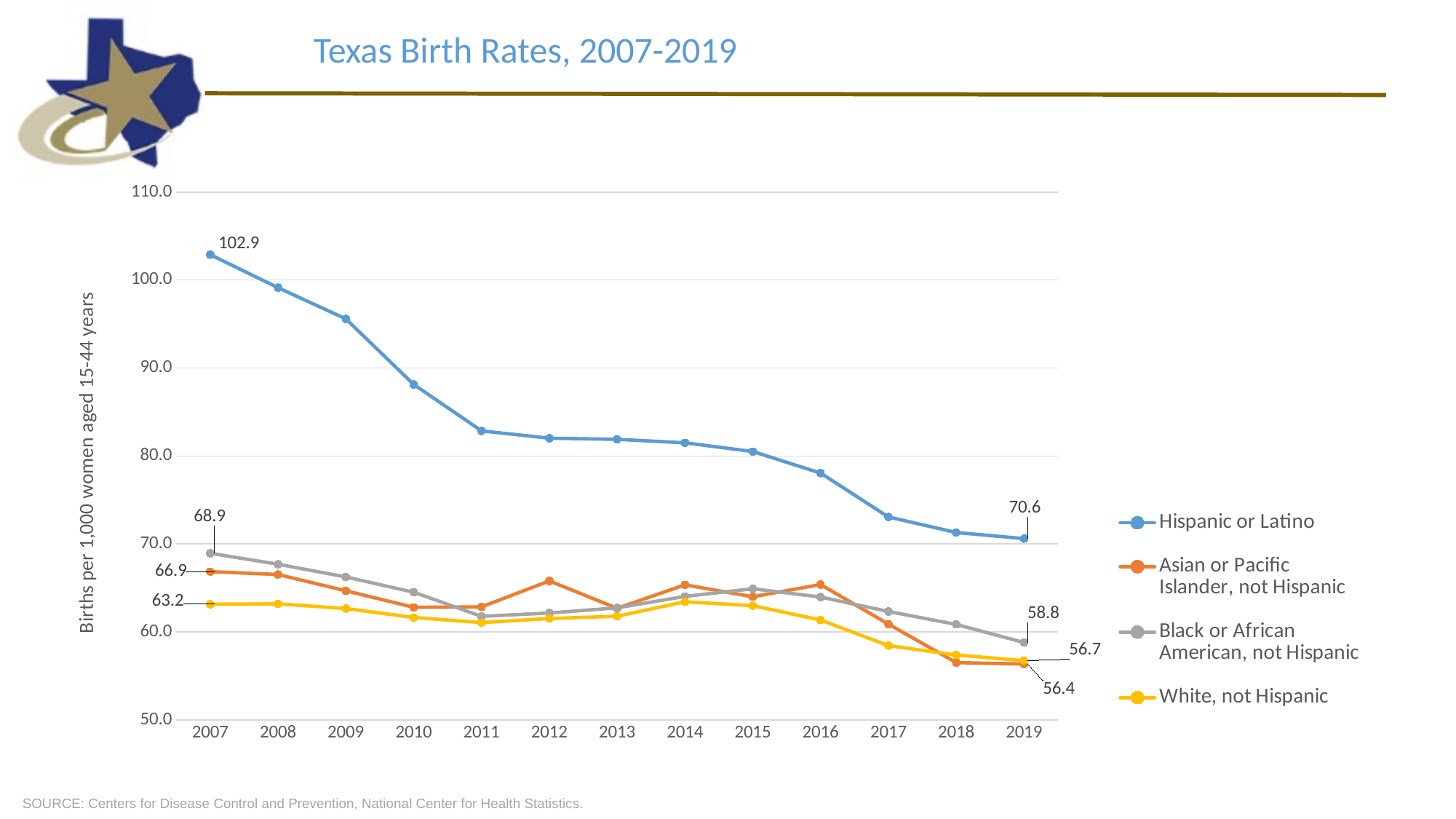
What was the birth rate for Hispanic or Latino women in 2019? 70.6 How many series does the legend list? 4 What was the birth rate for Black or African American, not Hispanic women in 2007? 68.9 What was the birth rate for White, not Hispanic women in 2019? 56.7 Which group had the highest birth rate in 2007? Hispanic or Latino In 2019, which group had the higher birth rate: Black or African American, not Hispanic or Asian or Pacific Islander, not Hispanic? Black or African American, not Hispanic What was the birth rate for Hispanic or Latino women in 2007? 102.9 Does the Hispanic or Latino birth rate rise or fall from 2007 to 2019? fall By how much did the Hispanic or Latino birth rate fall from 2007 to 2019? 32.3 What kind of chart is shown on the slide? line chart Is the Hispanic or Latino birth rate in 2011 greater or less than 80.0? greater How many years are plotted along the x axis? 13